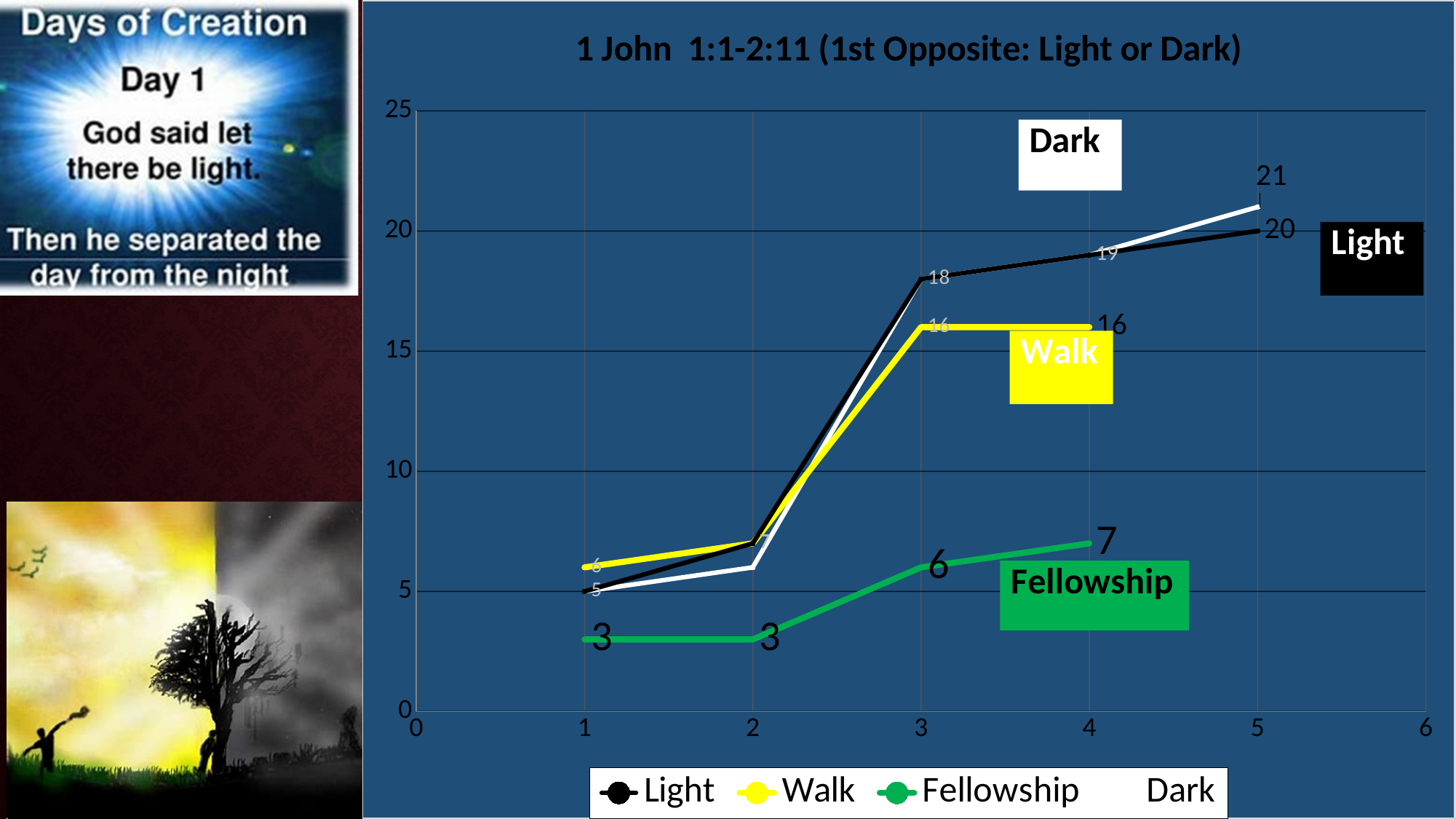
By how much does the Fellowship series increase from x = 1 to x = 4? 4 What is the value of the Fellowship series at x = 1? 3 What kind of chart is shown on the slide? line chart What is the title of the chart? 1 John 1:1-2:11 (1st Opposite: Light or Dark) What is the value of the Walk series at x = 3? 16 At x = 5, which series has the larger value, Dark or Light? Dark Is the value of the Light series at x = 2 greater or less than 10? less What is the value of the Fellowship series at x = 4? 7 What is the value of the Dark series at x = 5? 21 What is the value of the Walk series at x = 1? 6 What is the value of the Light series at x = 5? 20 How many series does the legend list? 4